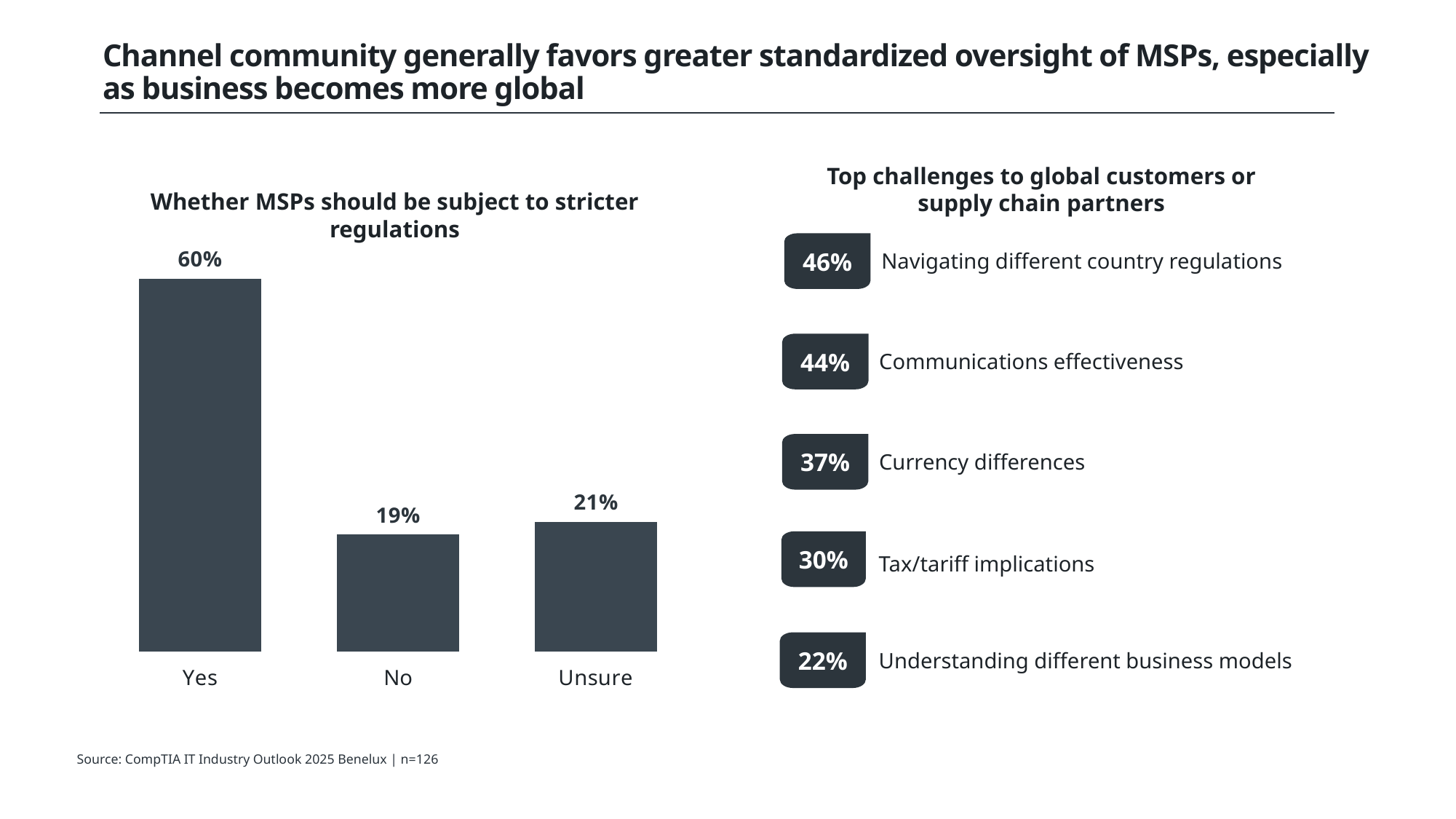
In the chart 'Whether MSPs should be subject to stricter regulations', which category has the lowest value? No In the list 'Top challenges to global customers or supply chain partners', which challenge has the highest value? Navigating different country regulations In the chart 'Whether MSPs should be subject to stricter regulations', which is larger, the value for No or the value for Unsure? Unsure In the list 'Top challenges to global customers or supply chain partners', what is the value for Currency differences? 37% In the chart 'Whether MSPs should be subject to stricter regulations', what is the value for Unsure? 21% In the chart 'Whether MSPs should be subject to stricter regulations', what is the difference between the values for Yes and Unsure? 39% How many categories are shown in the chart 'Whether MSPs should be subject to stricter regulations'? 3 In the chart 'Whether MSPs should be subject to stricter regulations', which category has the highest value? Yes In the chart 'Whether MSPs should be subject to stricter regulations', what is the value for No? 19% In the list 'Top challenges to global customers or supply chain partners', what is the difference between the values for Communications effectiveness and Tax/tariff implications? 14% What kind of chart is 'Whether MSPs should be subject to stricter regulations'? Bar chart In the chart 'Whether MSPs should be subject to stricter regulations', what is the value for Yes? 60%